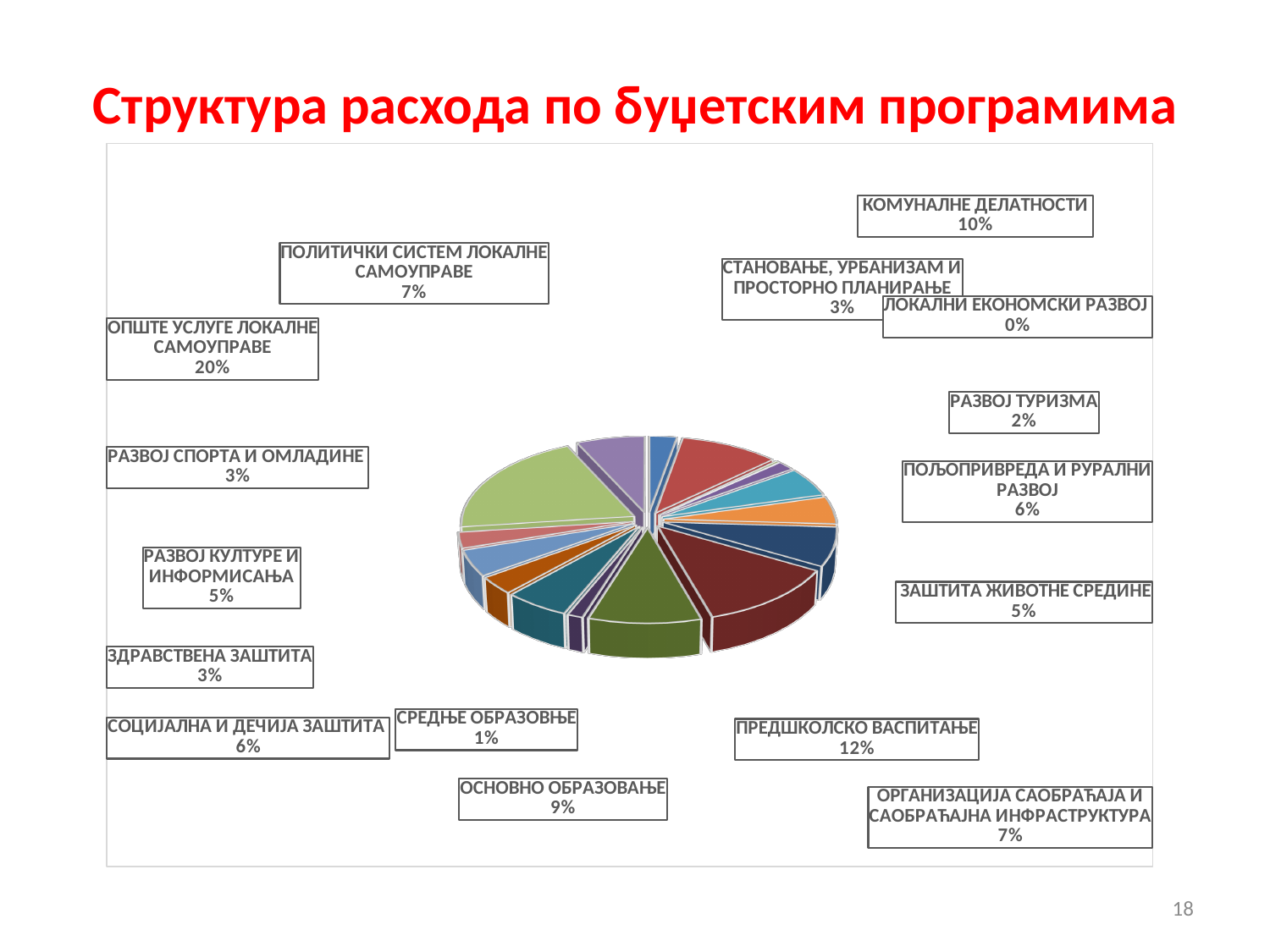
What percentage is shown for КОМУНАЛНЕ ДЕЛАТНОСТИ? 10% How many budget programmes are labelled in the pie chart? 16 What type of chart is shown on the slide? Pie chart What is the title of the slide's chart? Структура расхода по буџетским програмима What share is labelled for ОСНОВНО ОБРАЗОВАЊЕ? 9% What share of expenditure goes to ОПШТЕ УСЛУГЕ ЛОКАЛНЕ САМОУПРАВЕ? 20% What percentage is shown for ПРЕДШКОЛСКО ВАСПИТАЊЕ? 12% What percentage is shown for РАЗВОЈ ТУРИЗМА? 2% Which budget programme has the largest share of expenditure? ОПШТЕ УСЛУГЕ ЛОКАЛНЕ САМОУПРАВЕ What is the difference in percentage points between ОПШТЕ УСЛУГЕ ЛОКАЛНЕ САМОУПРАВЕ and ПРЕДШКОЛСКО ВАСПИТАЊЕ? 8 percentage points Which has a larger share: ОСНОВНО ОБРАЗОВАЊЕ or СРЕДЊЕ ОБРАЗОВЊЕ? ОСНОВНО ОБРАЗОВАЊЕ Which budget programme has the smallest share of expenditure? ЛОКАЛНИ ЕКОНОМСКИ РАЗВОЈ